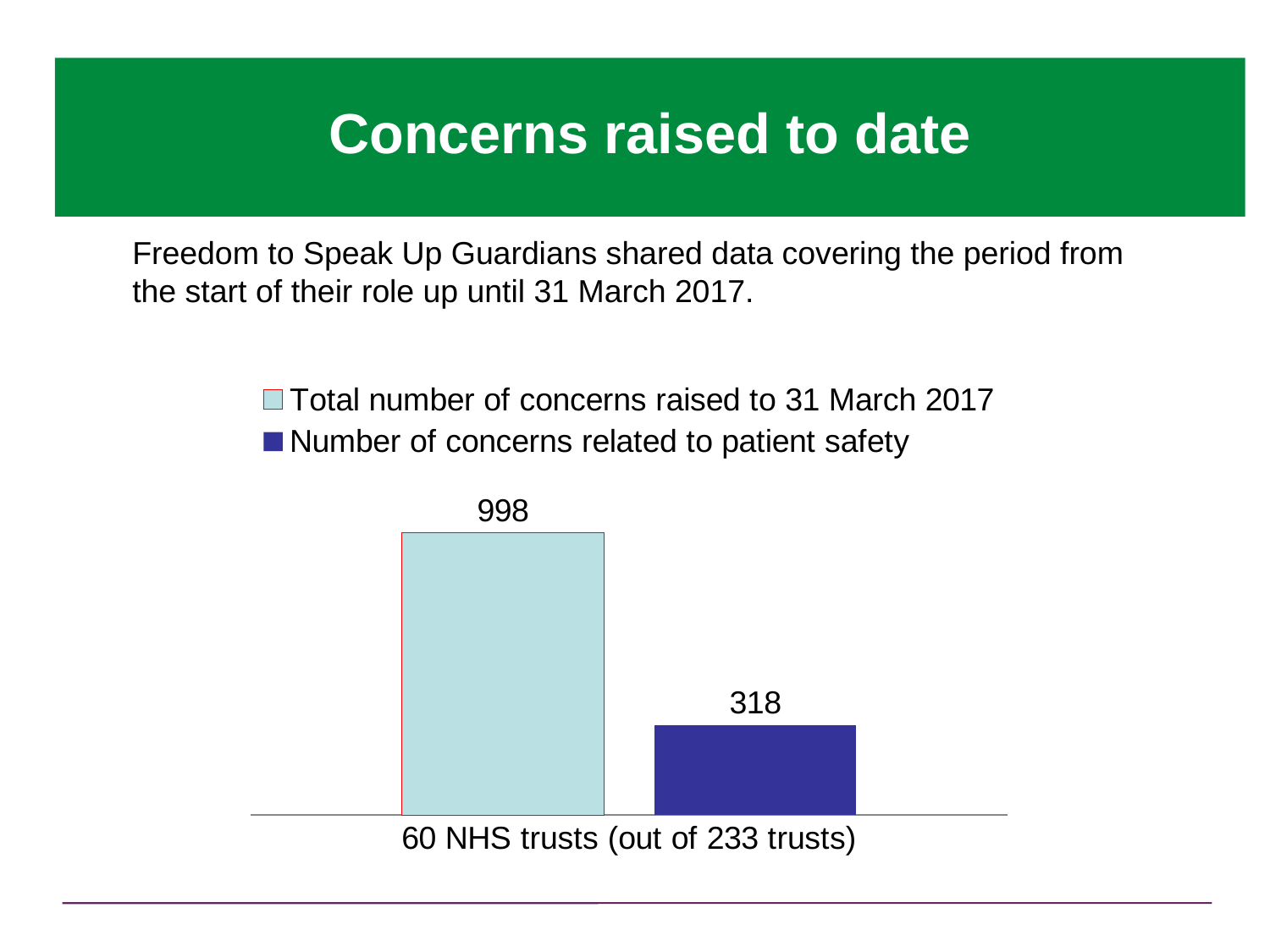
How many categories are shown on the x axis? 1 Which series has the lowest value on the chart? Number of concerns related to patient safety How many series does the legend list? 2 What is the category label on the x axis? 60 NHS trusts (out of 233 trusts) What is the difference between the total number of concerns raised and the number of concerns related to patient safety? 680 What is the number of concerns related to patient safety? 318 What colour is the bar for the number of concerns related to patient safety? Dark blue Which series has the higher value: total number of concerns raised or number of concerns related to patient safety? Total number of concerns raised to 31 March 2017 What is the total number of concerns raised to 31 March 2017? 998 What kind of chart is shown on the slide? Bar chart